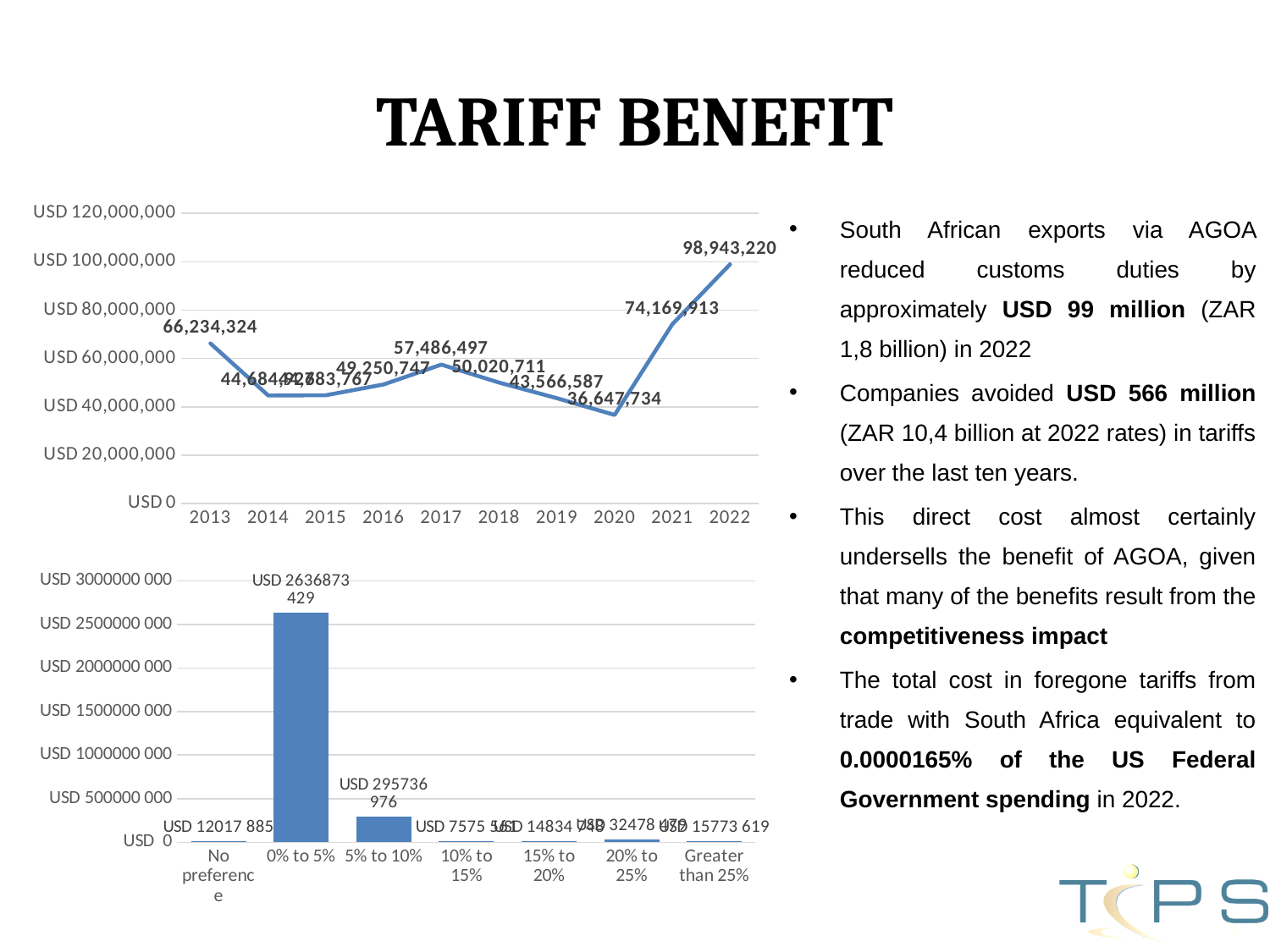
How many years are plotted in the top chart? 10 What kind of chart is the top chart on the slide? line chart In the top chart, which year has the highest value? 2022 In the top chart, is the value for 2013 greater or less than USD 60,000,000? greater In the top chart, what is the value for 2022? 98,943,220 In the bottom chart, what is the value for the 0% to 5% category? USD 2636873 429 In the bottom chart, which category has the highest value? 0% to 5% In the top chart, which is larger, the value for 2017 or the value for 2018? 2017 In the top chart, which year has the lowest value? 2020 In the top chart, what is the difference between the values for 2022 and 2021? 24,773,307 In the top chart, do the values rise or fall from 2020 to 2022? rise What kind of chart is the bottom chart on the slide? bar chart